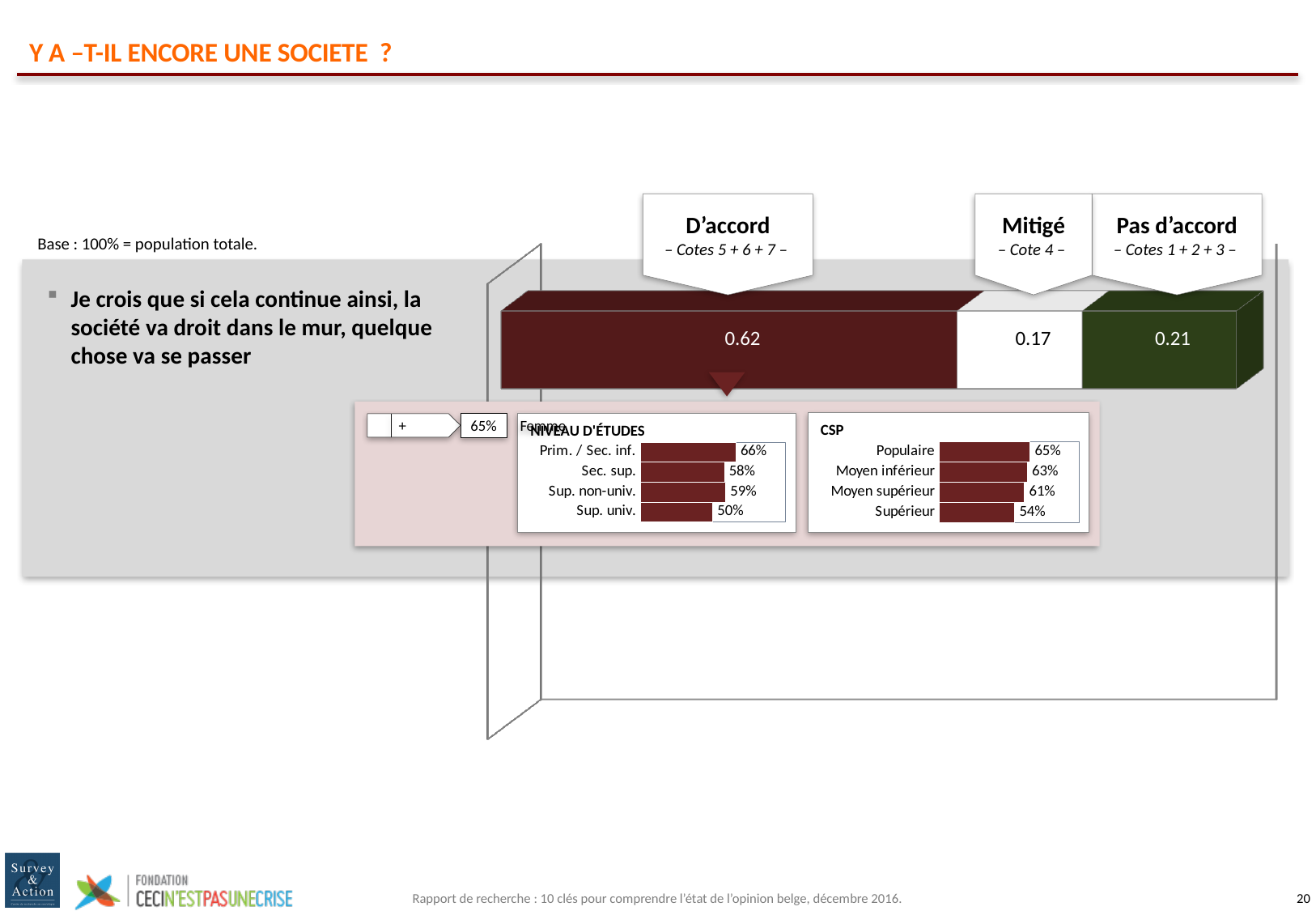
In the 'NIVEAU D'ÉTUDES' chart, how many categories are shown? 4 In the main stacked bar chart, what is the difference between the 'Pas d'accord' and 'Mitigé' values? 0.04 In the main stacked bar chart, what is the value for the 'Pas d'accord' segment? 0.21 In the 'NIVEAU D'ÉTUDES' chart, what is the value for 'Sup. univ.'? 50% In the 'CSP' chart, which category has the lowest value? Supérieur In the main stacked bar chart, which segment is the largest? D'accord What kind of chart is the 'CSP' chart? Bar chart In the main stacked bar chart, what is the value for the 'Mitigé' segment? 0.17 In the main stacked bar chart, what is the value for the 'D'accord' segment? 0.62 In the 'CSP' chart, what is the difference between 'Populaire' and 'Supérieur'? 11% In the 'NIVEAU D'ÉTUDES' chart, which category has the highest value? Prim. / Sec. inf. In the 'CSP' chart, what is the value for 'Moyen inférieur'? 63%